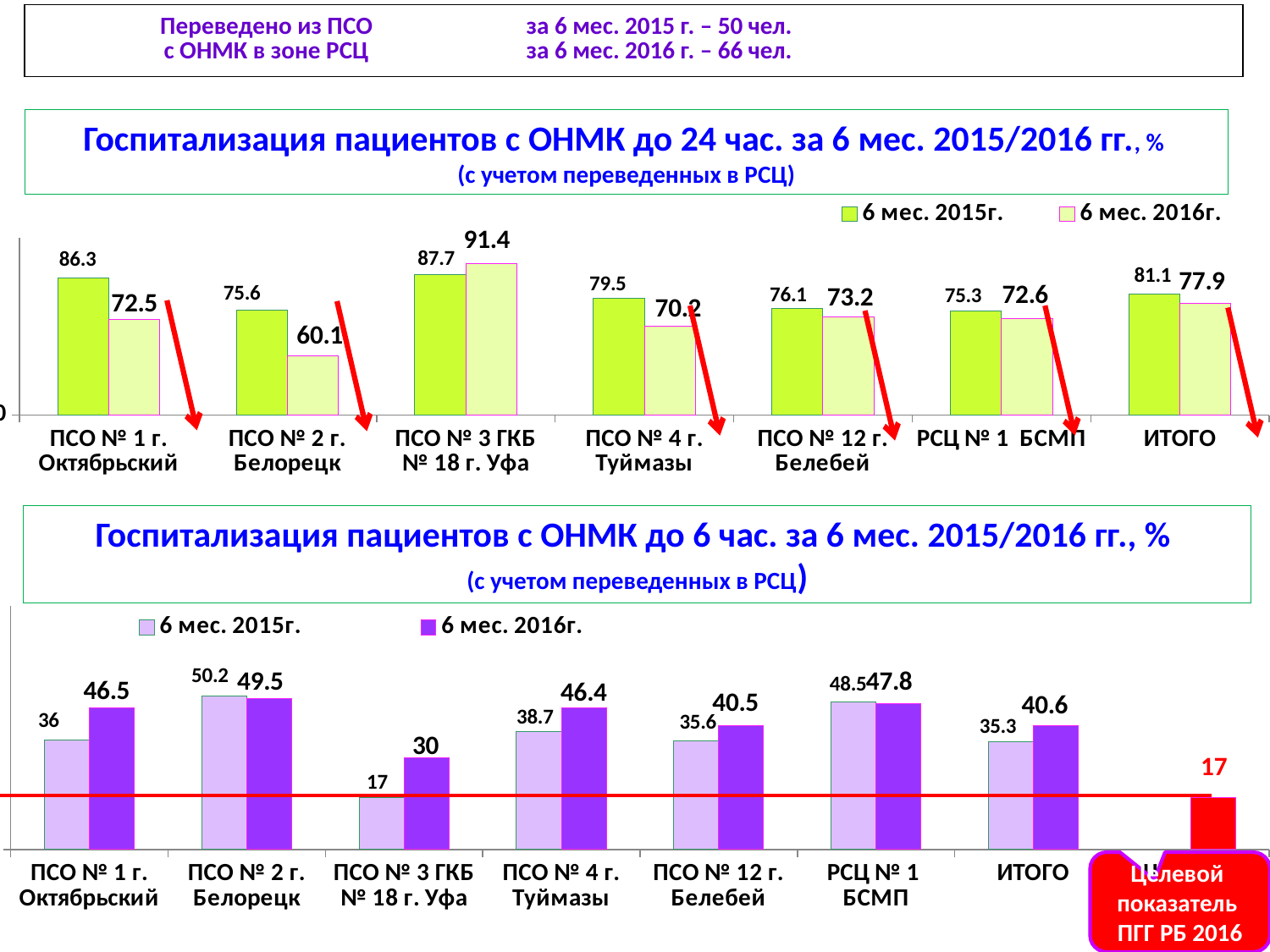
In the top chart (до 24 час.), which category has the highest value for 6 мес. 2016г.? ПСО № 3 ГКБ № 18 г. Уфа In the top chart (до 24 час.), how many series does the legend list? 2 In the top chart (до 24 час.), which category has the lowest value for 6 мес. 2016г.? ПСО № 2 г. Белорецк In the bottom chart (до 6 час.), what is the ИТОГО value for 6 мес. 2015г.? 35.3 In the bottom chart (до 6 час.), which category has the lowest value for 6 мес. 2015г.? ПСО № 3 ГКБ № 18 г. Уфа In the bottom chart (до 6 час.), what is the value for ПСО № 4 г. Туймазы for 6 мес. 2016г.? 46.4 In the bottom chart (до 6 час.), which is larger for ПСО № 2 г. Белорецк: the 6 мес. 2015г. value or the 6 мес. 2016г. value? 6 мес. 2015г. In the bottom chart (до 6 час.), what is the value of the target indicator (Целевой показатель ПГГ РБ 2016)? 17 In the top chart (до 24 час.), what is the difference between the 6 мес. 2015г. and 6 мес. 2016г. values for ПСО № 1 г. Октябрьский? 13.8 In the top chart (до 24 час.), what is the value for ПСО № 3 ГКБ № 18 г. Уфа for 6 мес. 2015г.? 87.7 In the top chart (до 24 час.), what is the value for ПСО № 2 г. Белорецк for 6 мес. 2016г.? 60.1 What type of chart is the bottom chart (до 6 час.)? Bar chart